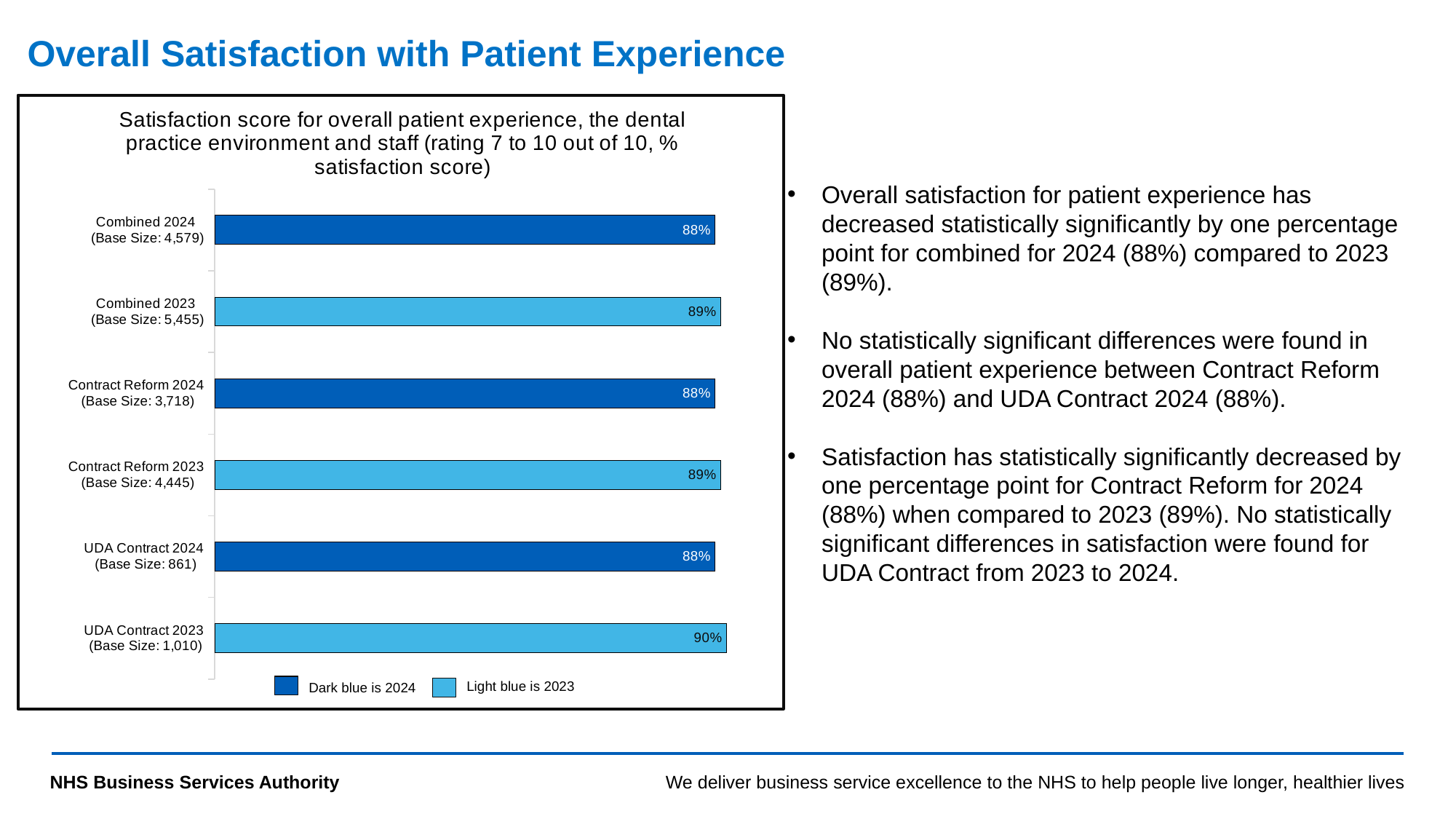
What is the satisfaction score for Combined 2023? 89% What type of chart is shown on the slide? Bar chart What is the difference between the satisfaction scores for UDA Contract 2023 and UDA Contract 2024? 2% What is the satisfaction score for UDA Contract 2023? 90% What is the base size shown for Contract Reform 2023? 4,445 Which category has the highest satisfaction score? UDA Contract 2023 According to the legend, which year do the dark blue bars represent? 2024 What is the satisfaction score for Contract Reform 2024? 88% Which is larger, the satisfaction score for Combined 2023 or Combined 2024? Combined 2023 What is the difference between the satisfaction scores for Contract Reform 2023 and Contract Reform 2024? 1% What is the satisfaction score for Combined 2024? 88% How many bars are shown in the chart? 6